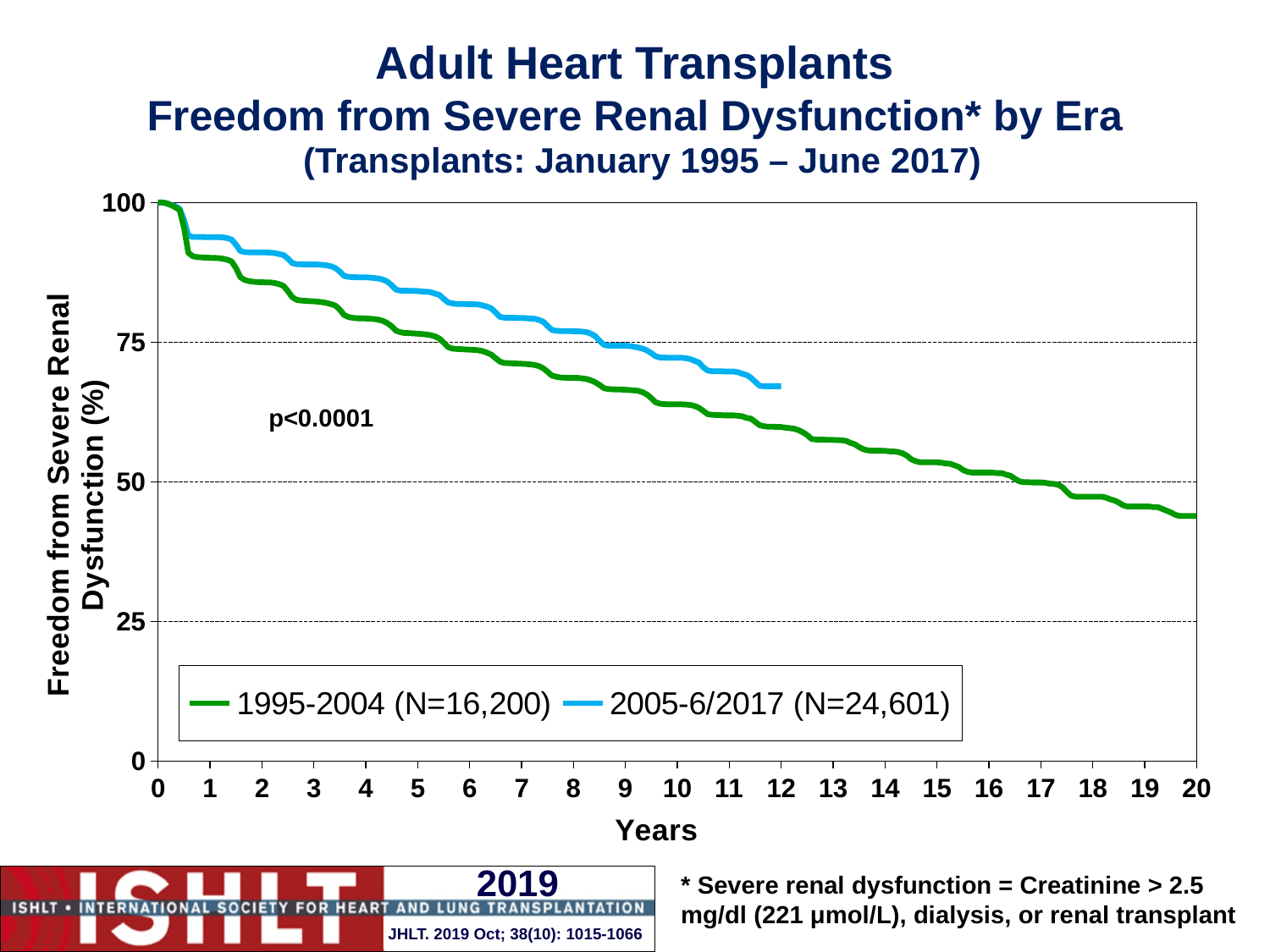
Do the values for the 1995-2004 series rise or fall as years increase? fall Is the value for the 1995-2004 series at 20 years greater or less than 50? less Is the value for the 1995-2004 series at 10 years greater or less than 50? greater What p-value is printed on the chart? p<0.0001 What is the sample size (N) shown in the legend for the 1995-2004 series? 16,200 What kind of chart is shown on the slide? line chart How many series does the legend list? 2 Do the values for the 2005-6/2017 series rise or fall as years increase? fall Is the value for the 2005-6/2017 series at 5 years greater or less than 75? greater At 5 years, which series has the higher freedom from severe renal dysfunction, 1995-2004 or 2005-6/2017? 2005-6/2017